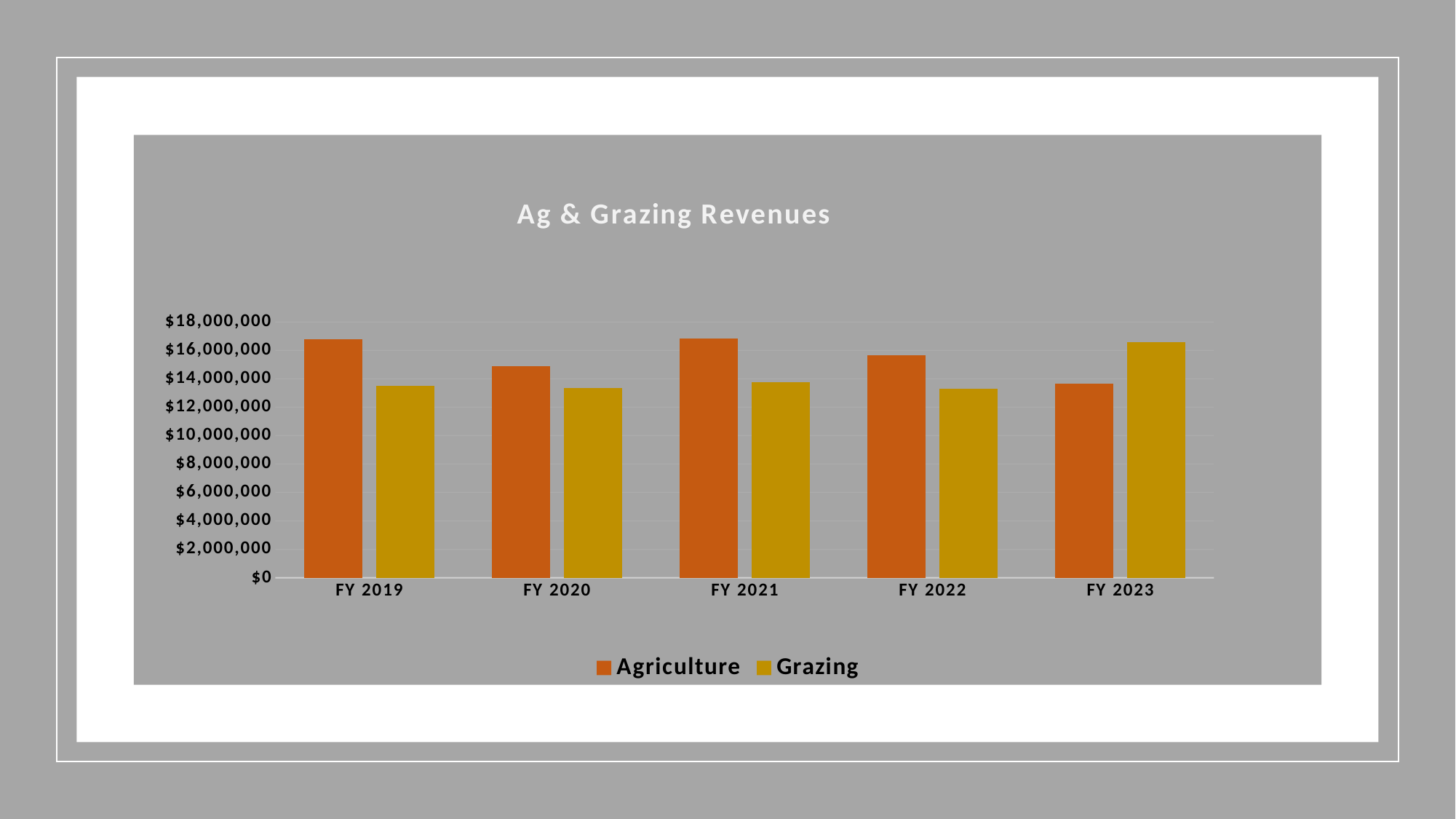
Which colour represents the Grazing series in the legend? gold In which fiscal year is the Grazing revenue highest? FY 2023 In FY 2019, which is larger, Agriculture or Grazing revenue? Agriculture Is the Grazing value for FY 2023 greater or less than $16,000,000? greater Is the Agriculture value for FY 2020 greater or less than $14,000,000? greater How many fiscal years are shown on the x axis? 5 How many series does the legend list? 2 In FY 2023, which is larger, Agriculture or Grazing revenue? Grazing Is the Grazing value for FY 2019 greater or less than $14,000,000? less What type of chart is shown on the slide? bar chart What is the title of the chart? Ag & Grazing Revenues In which fiscal year is the Agriculture revenue lowest? FY 2023